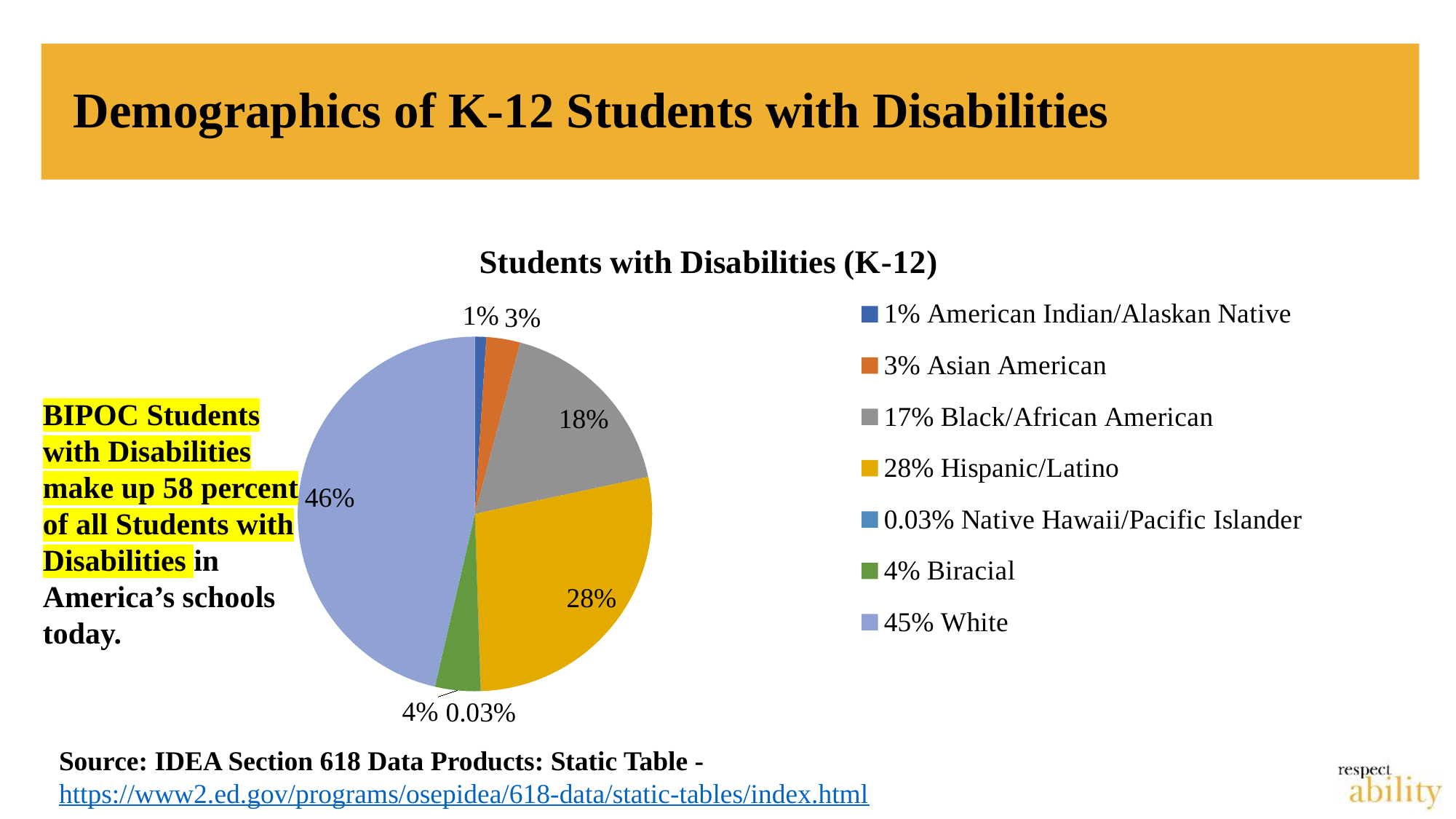
What percentage of students with disabilities are Hispanic/Latino? 28% What percentage of students with disabilities are Biracial? 4% Which category has the largest share of the pie? White What is the difference between the Hispanic/Latino share and the Biracial share? 24% What percentage of students with disabilities are Asian American? 3% What is the title of the chart? Students with Disabilities (K-12) What percentage of students with disabilities are American Indian/Alaskan Native? 1% Which category has the smallest share of the pie? Native Hawaii/Pacific Islander What kind of chart is shown on the slide? Pie chart How many categories does the pie chart's legend list? 7 Which is larger, the share for Hispanic/Latino or the share for Black/African American? Hispanic/Latino What percentage of students with disabilities are Native Hawaii/Pacific Islander? 0.03%